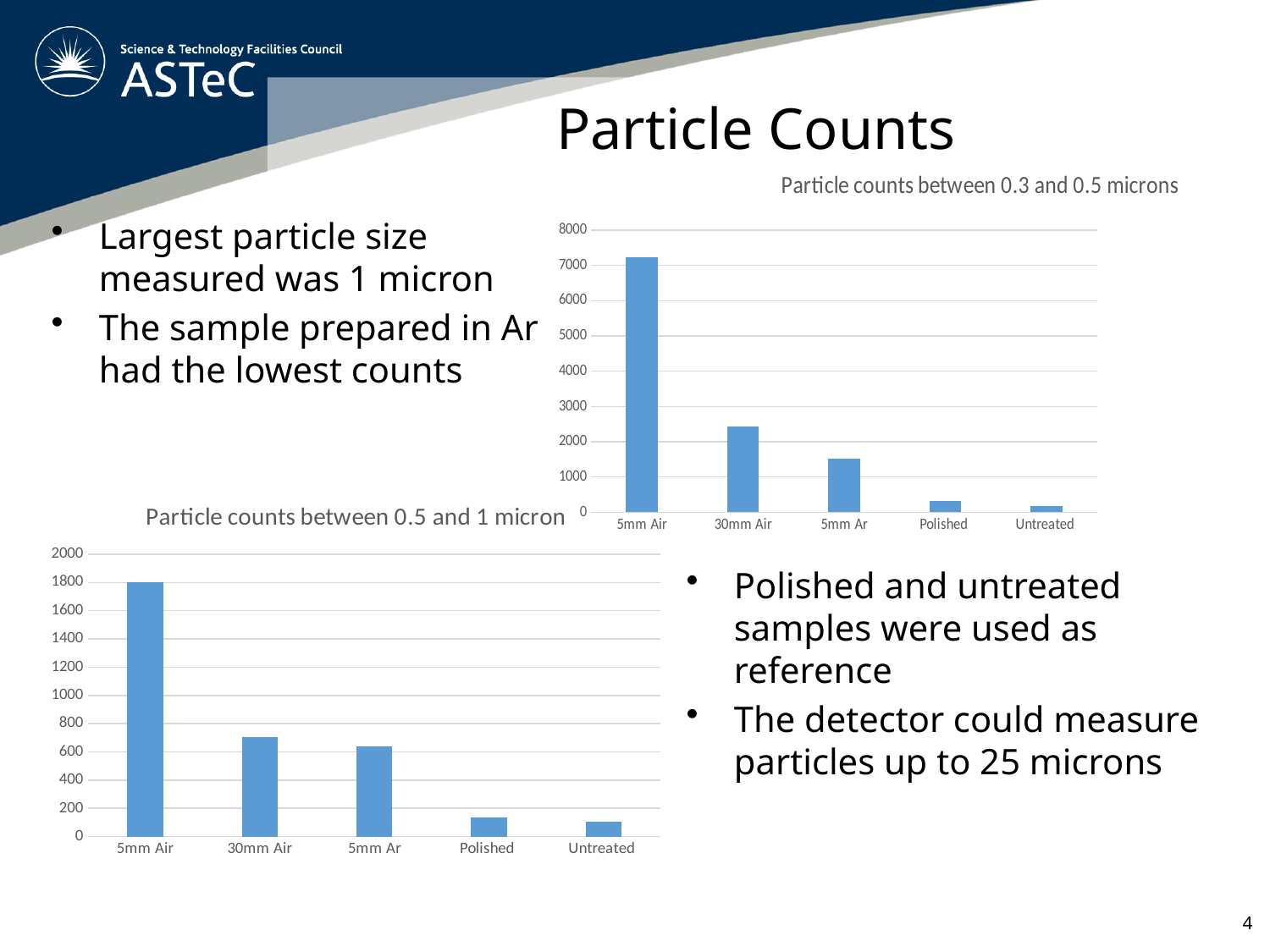
In the 'Particle counts between 0.3 and 0.5 microns' chart, which is larger, the value for 30mm Air or the value for 5mm Ar? 30mm Air In the 'Particle counts between 0.3 and 0.5 microns' chart, which category has the lowest value? Untreated In the 'Particle counts between 0.3 and 0.5 microns' chart, is the value for 30mm Air greater or less than 3000? less In the 'Particle counts between 0.3 and 0.5 microns' chart, is the value for 5mm Air greater or less than 7000? greater In the 'Particle counts between 0.5 and 1 micron' chart, do the values generally rise or fall from left to right along the x axis? fall What is the title of the chart in the bottom left of the slide? Particle counts between 0.5 and 1 micron How many categories are shown on the x axis of the 'Particle counts between 0.5 and 1 micron' chart? 5 In the 'Particle counts between 0.5 and 1 micron' chart, which category has the highest value? 5mm Air What kind of chart is the 'Particle counts between 0.3 and 0.5 microns' chart? bar chart In the 'Particle counts between 0.3 and 0.5 microns' chart, which category has the highest value? 5mm Air In the 'Particle counts between 0.5 and 1 micron' chart, is the value for 5mm Ar greater or less than 400? greater In the 'Particle counts between 0.5 and 1 micron' chart, which category has the lowest value? Untreated